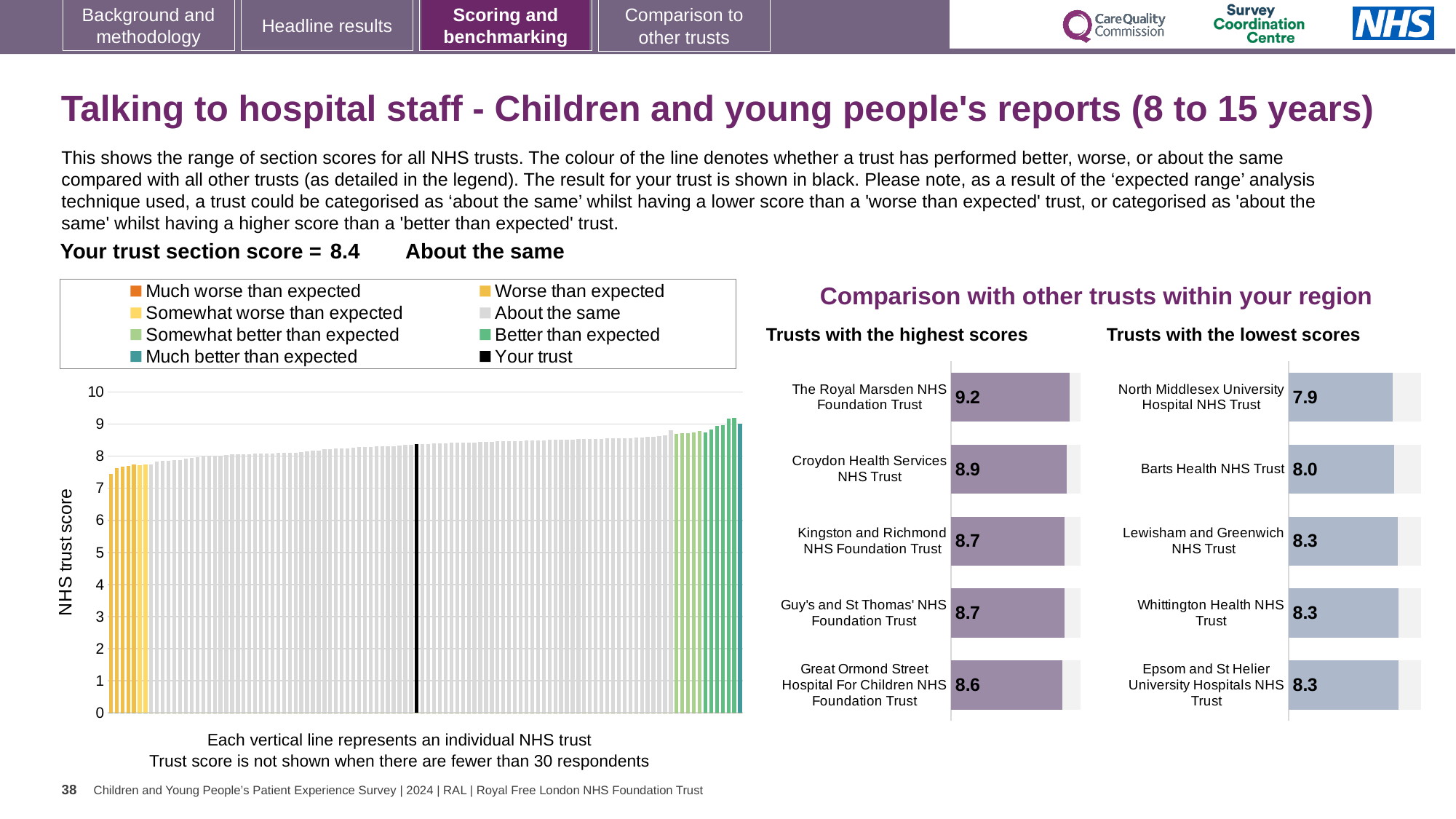
In the 'Trusts with the highest scores' chart, which trust has the highest score? The Royal Marsden NHS Foundation Trust In the 'Trusts with the highest scores' chart, what is the score for The Royal Marsden NHS Foundation Trust? 9.2 In the large chart on the left, what is the label on the vertical axis? NHS trust score In the 'Trusts with the lowest scores' chart, which trust has the lowest score? North Middlesex University Hospital NHS Trust In the 'Trusts with the highest scores' chart, what is the difference between the scores of The Royal Marsden NHS Foundation Trust and Great Ormond Street Hospital For Children NHS Foundation Trust? 0.6 What kind of chart is the large chart on the left showing NHS trust scores? bar chart In the large chart on the left, is the value for the black bar (your trust) greater or less than 8? greater How many entries does the legend above the large chart on the left list? 8 In the 'Trusts with the lowest scores' chart, what is the score for Barts Health NHS Trust? 8.0 In the large chart on the left, do the trust scores rise or fall from left to right? rise How many trusts are shown in the 'Trusts with the lowest scores' chart? 5 What is your trust's section score shown on the slide? 8.4